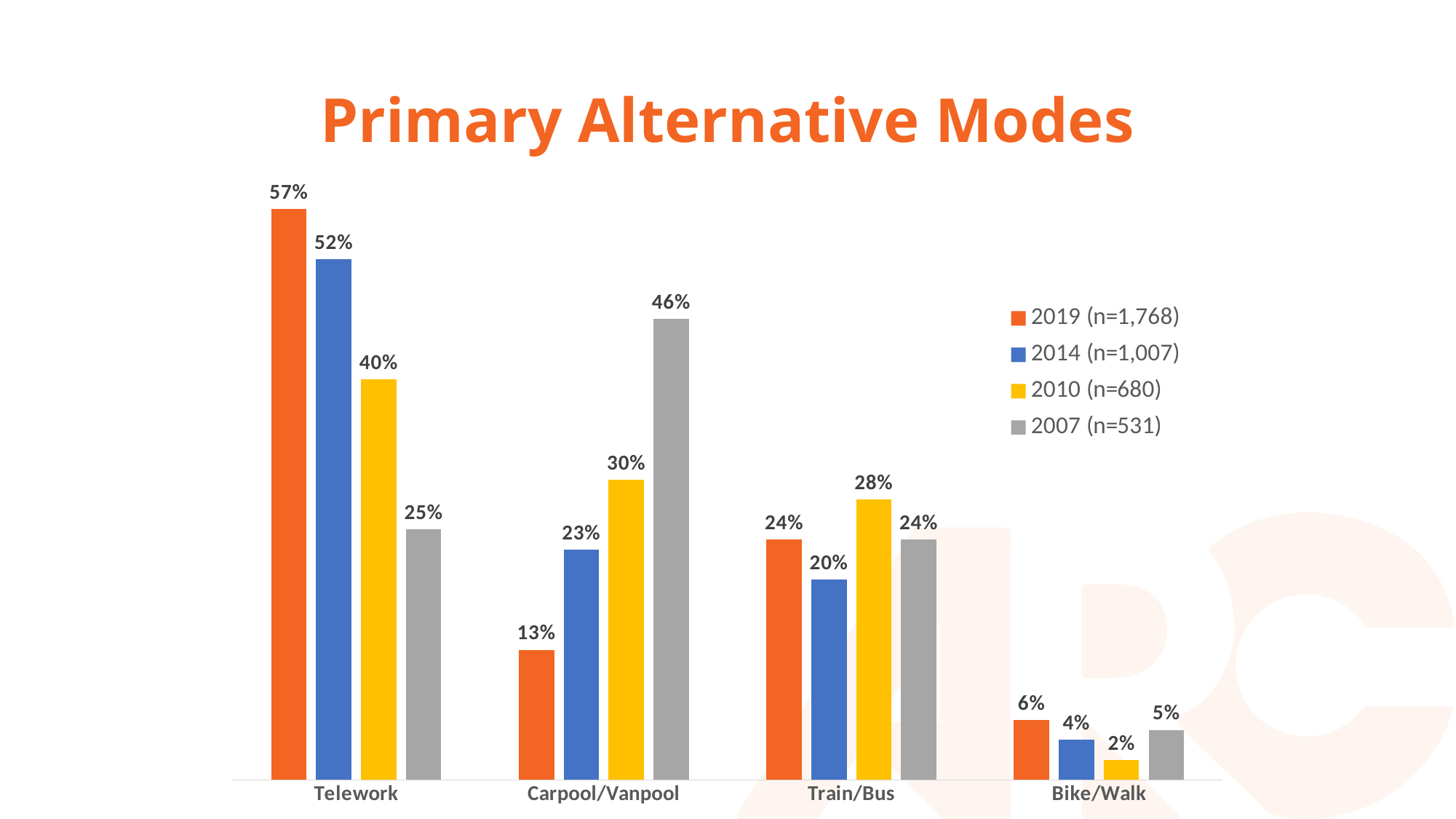
What is the value for Telework in the 2019 (n=1,768) series? 57% What is the value for Bike/Walk in the 2010 (n=680) series? 2% How many series does the legend list? 4 Which category has the highest value in the 2019 (n=1,768) series? Telework What is the value for Carpool/Vanpool in the 2007 (n=531) series? 46% What is the title of the chart? Primary Alternative Modes What is the difference between the 2019 and 2007 values for Telework? 32% Which category has the lowest value in the 2007 (n=531) series? Bike/Walk What is the value for Train/Bus in the 2014 (n=1,007) series? 20% Which is larger for Carpool/Vanpool: the 2010 (n=680) value or the 2014 (n=1,007) value? 2010 (n=680) What kind of chart is shown on the slide? Bar chart How many categories are shown on the x axis? 4